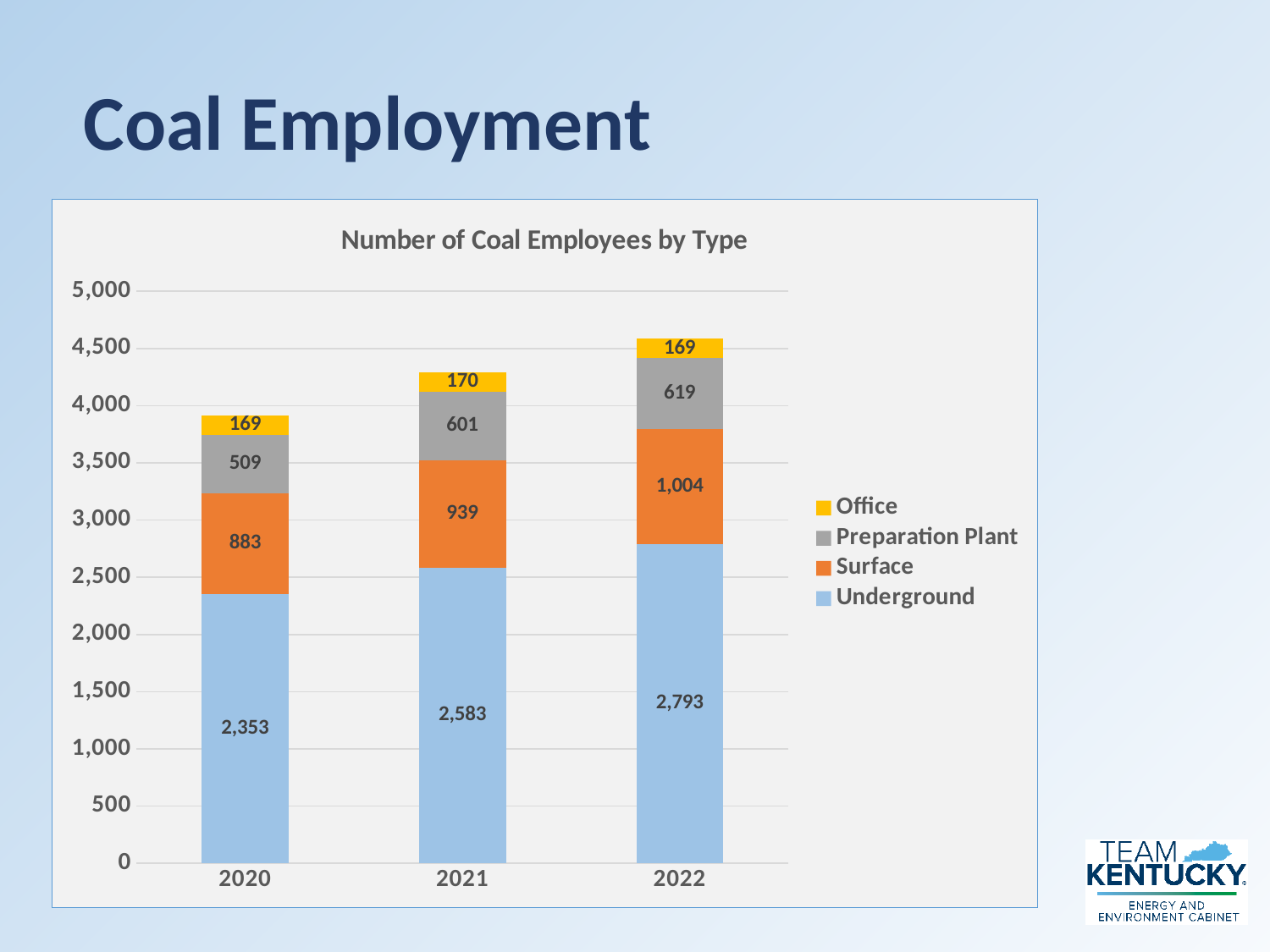
What is the total number of coal employees in 2020 across all types? 3,914 Is the number of Surface employees larger in 2021 or in 2020? 2021 What is the number of Underground coal employees in 2021? 2,583 How many series does the legend list? 4 What kind of chart is shown on the slide? Stacked bar chart What is the total number of coal employees in 2022 across all types? 4,585 What is the number of Preparation Plant employees in 2020? 509 What is the number of Surface coal employees in 2022? 1,004 Which year has the highest number of Underground employees? 2022 Which year has the lowest number of Preparation Plant employees? 2020 What is the difference in Underground employees between 2022 and 2020? 440 What is the number of Office employees in 2021? 170